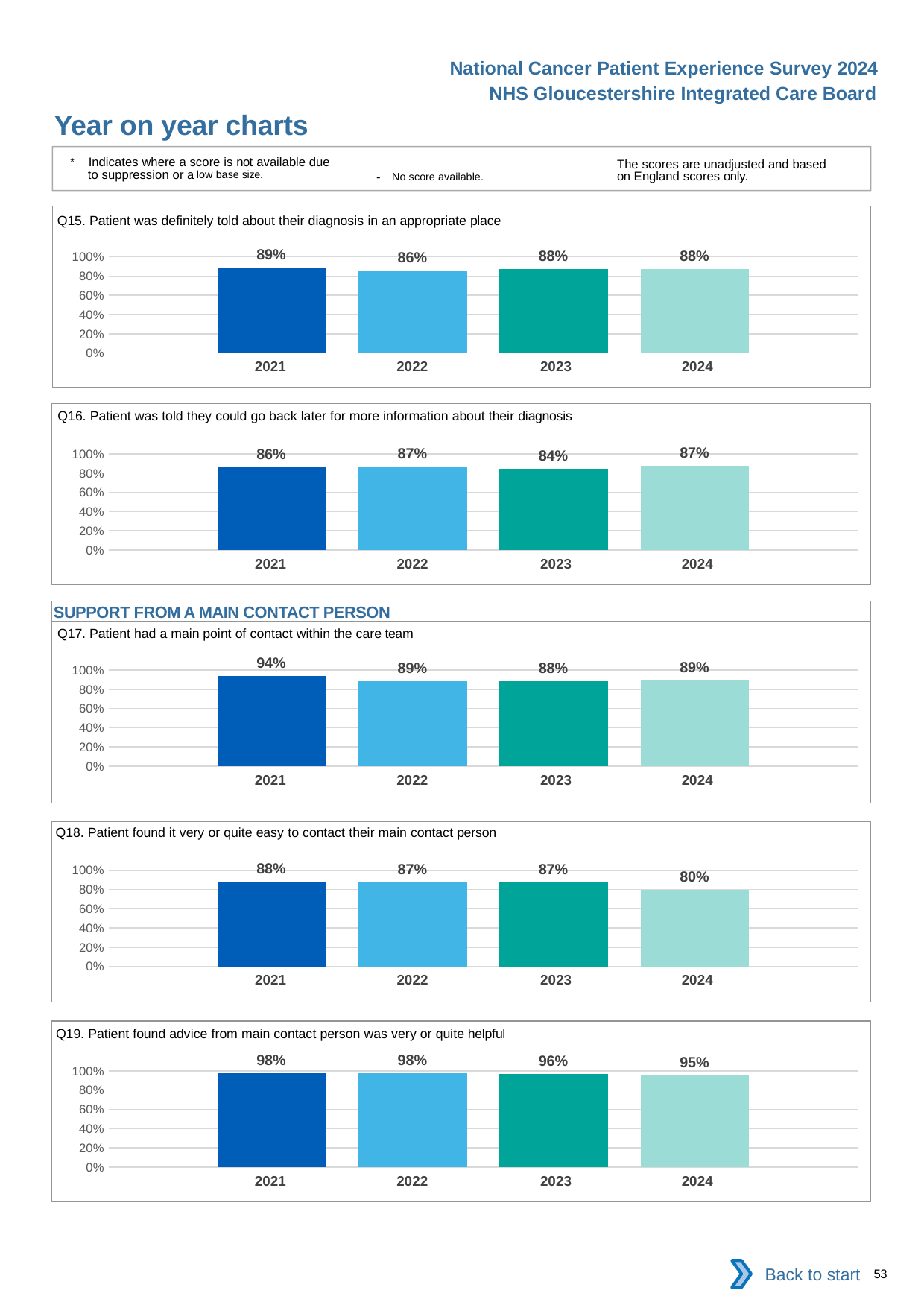
In the Q15 chart (patient was definitely told about their diagnosis in an appropriate place), what is the value for 2022? 86% In the Q17 chart, which year has the highest value? 2021 In the Q17 chart (patient had a main point of contact within the care team), what is the difference between the 2021 and 2022 values? 5 percentage points What type of chart is the Q18 chart? bar chart In the Q19 chart, what is the difference between the 2022 and 2024 values? 3 percentage points In the Q18 chart, which is larger, the value for 2021 or the value for 2024? 2021 How many years are shown on the x axis of the Q15 chart? 4 In the Q16 chart, what is the value for 2024? 87% In the Q19 chart (patient found advice from main contact person was very or quite helpful), do the values rise or fall from 2021 to 2024? fall In the Q15 chart, which year has the highest value? 2021 In the Q18 chart (patient found it very or quite easy to contact their main contact person), what is the value for 2024? 80% In the Q16 chart (patient was told they could go back later for more information about their diagnosis), which year has the lowest value? 2023